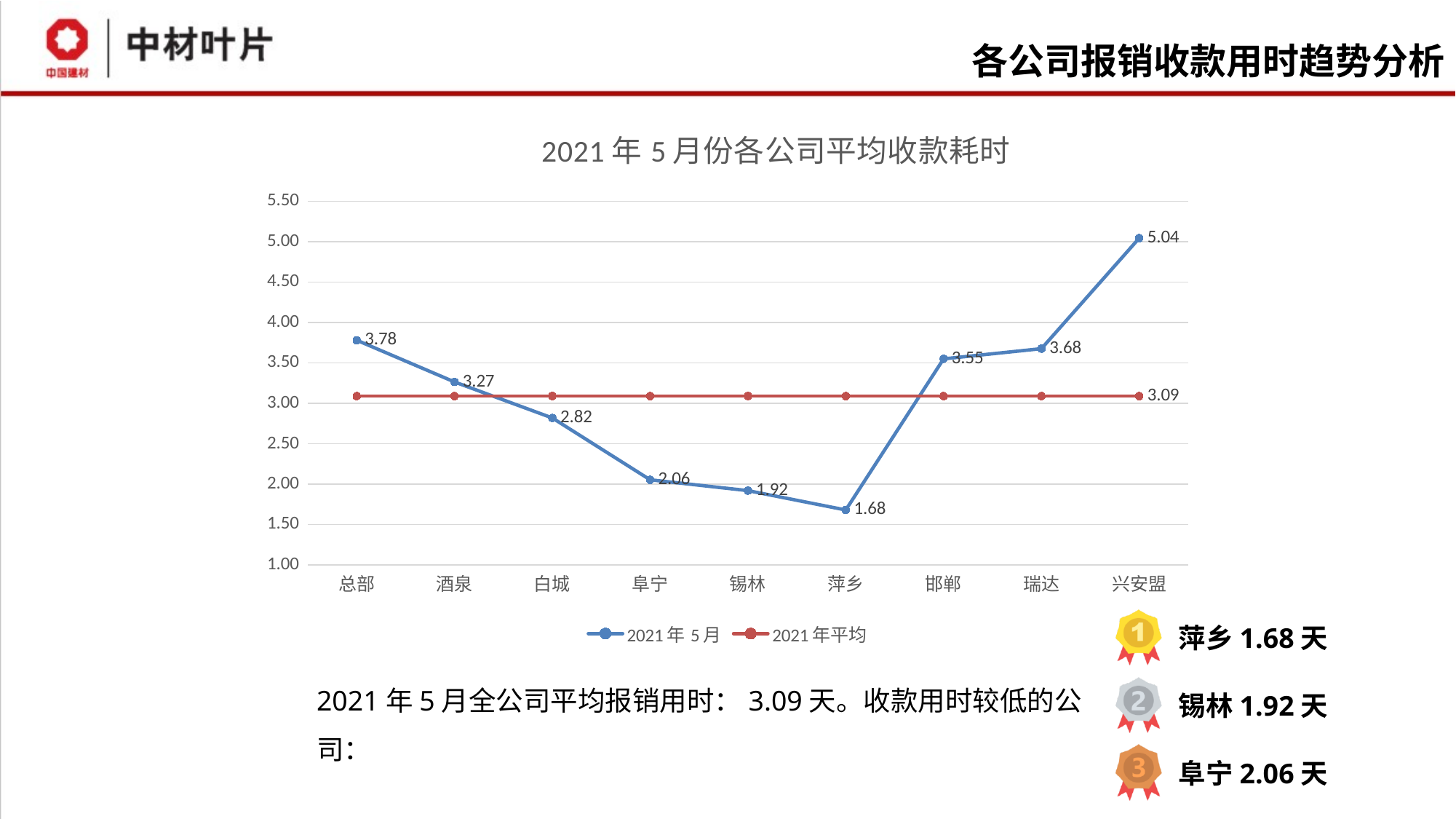
What is the difference between the 2021年5月 values for 兴安盟 and 萍乡? 3.36 What is the value for 总部 in the 2021年5月 series? 3.78 What kind of chart is shown? line chart Which company has the lowest value in the 2021年5月 series? 萍乡 What is the value for 兴安盟 in the 2021年5月 series? 5.04 How many series does the legend list? 2 Which has a larger 2021年5月 value, 邯郸 or 瑞达? 瑞达 What is the title of the chart? 2021年5月份各公司平均收款耗时 Which company has the highest value in the 2021年5月 series? 兴安盟 How many companies are shown on the x axis? 9 Is the 2021年5月 value for 白城 greater or less than 3.00? less What is the value of the 2021年平均 line? 3.09